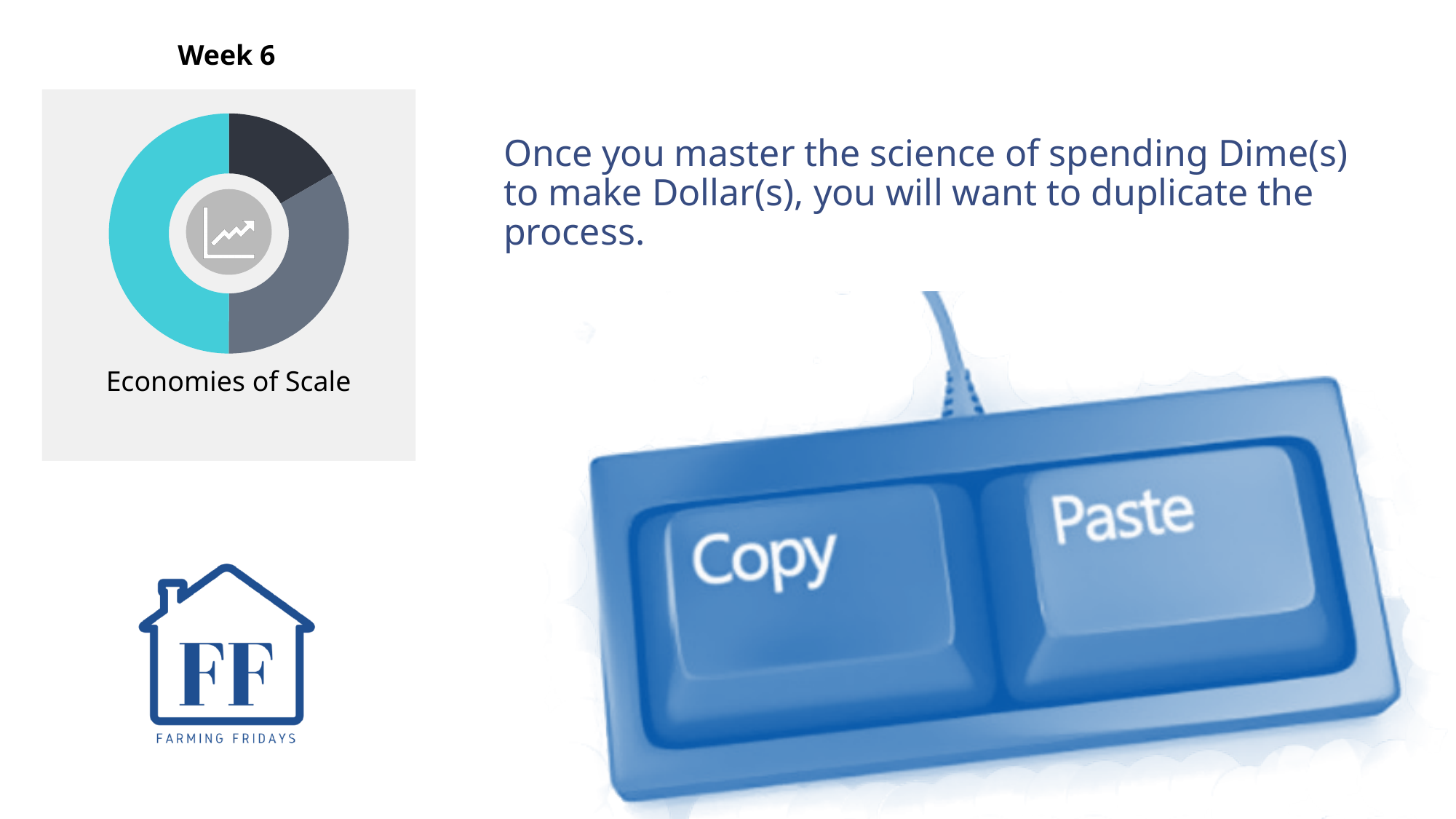
What kind of chart is shown in the Economies of Scale panel on the left? Pie (donut) chart Which colour segment of the Economies of Scale donut chart is the largest? Teal Does the Economies of Scale donut chart show a legend? No What label appears beneath the donut chart on the left of the slide? Economies of Scale How many segments does the donut chart in the Economies of Scale panel have? 3